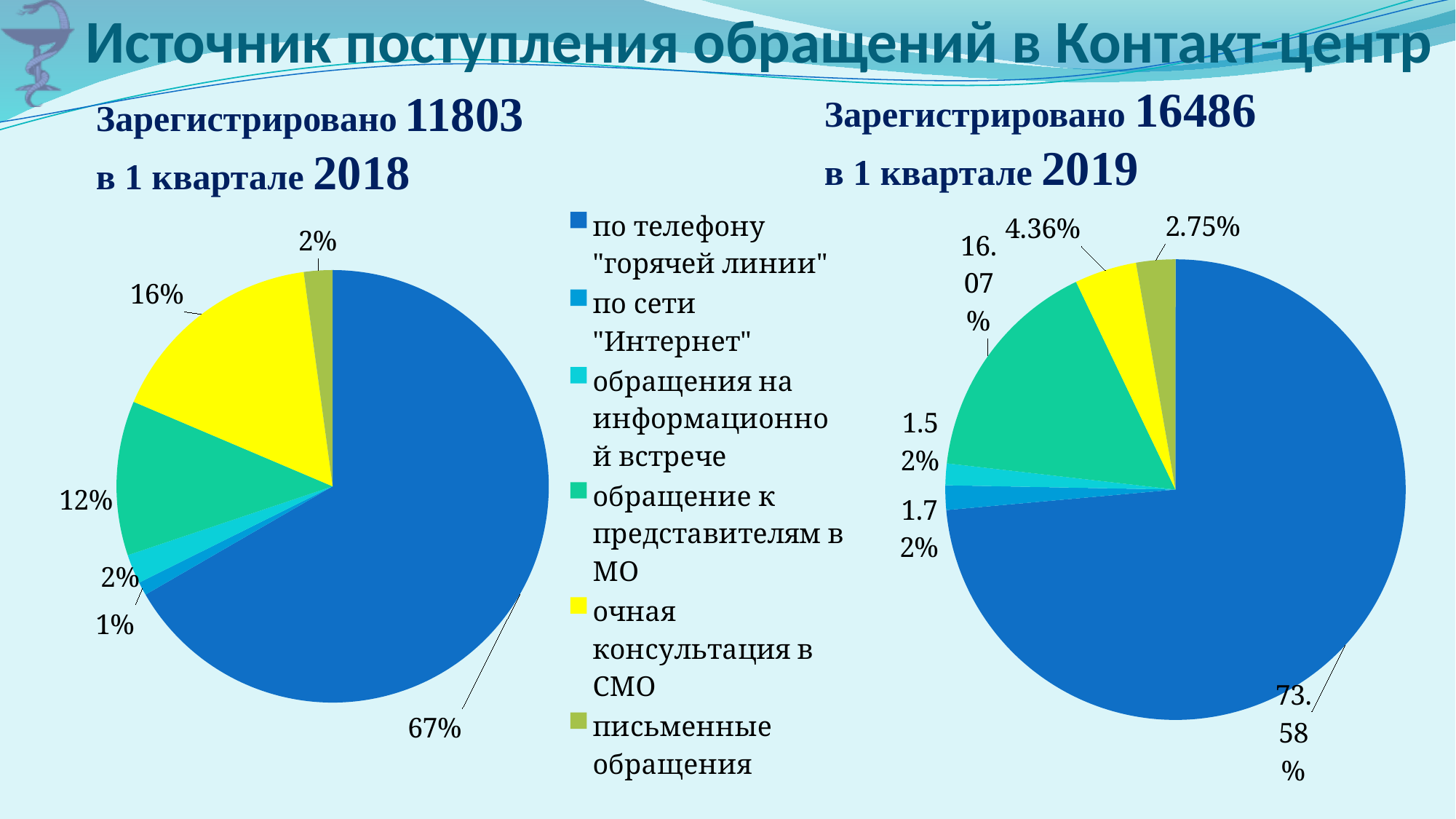
In the left pie chart (1 квартал 2018), which source has the smallest share? по сети "Интернет" In the left pie chart (1 квартал 2018), what is the difference in percentage points between the share for по телефону "горячей линии" and the share for очная консультация в СМО? 51 In the right pie chart (1 квартал 2019), what share is labelled for обращение к представителям в МО? 16.07% According to the text above the right pie chart, how many requests were registered in 1 квартал 2019? 16486 In the right pie chart (1 квартал 2019), what share of requests came по телефону "горячей линии"? 73.58% In the left pie chart (1 квартал 2018), what share of requests came по телефону "горячей линии"? 67% What kind of chart is used on the left side of the slide (1 квартал 2018)? pie chart How many entries does the shared legend between the two pie charts list? 6 In the right pie chart (1 квартал 2019), which source has the largest share? по телефону "горячей линии" In the left pie chart (1 квартал 2018), what share is labelled for очная консультация в СМО? 16% In the right pie chart (1 квартал 2019), which is larger: the share for очная консультация в СМО or the share for письменные обращения? очная консультация в СМО In the right pie chart (1 квартал 2019), what share is labelled for письменные обращения? 2.75%